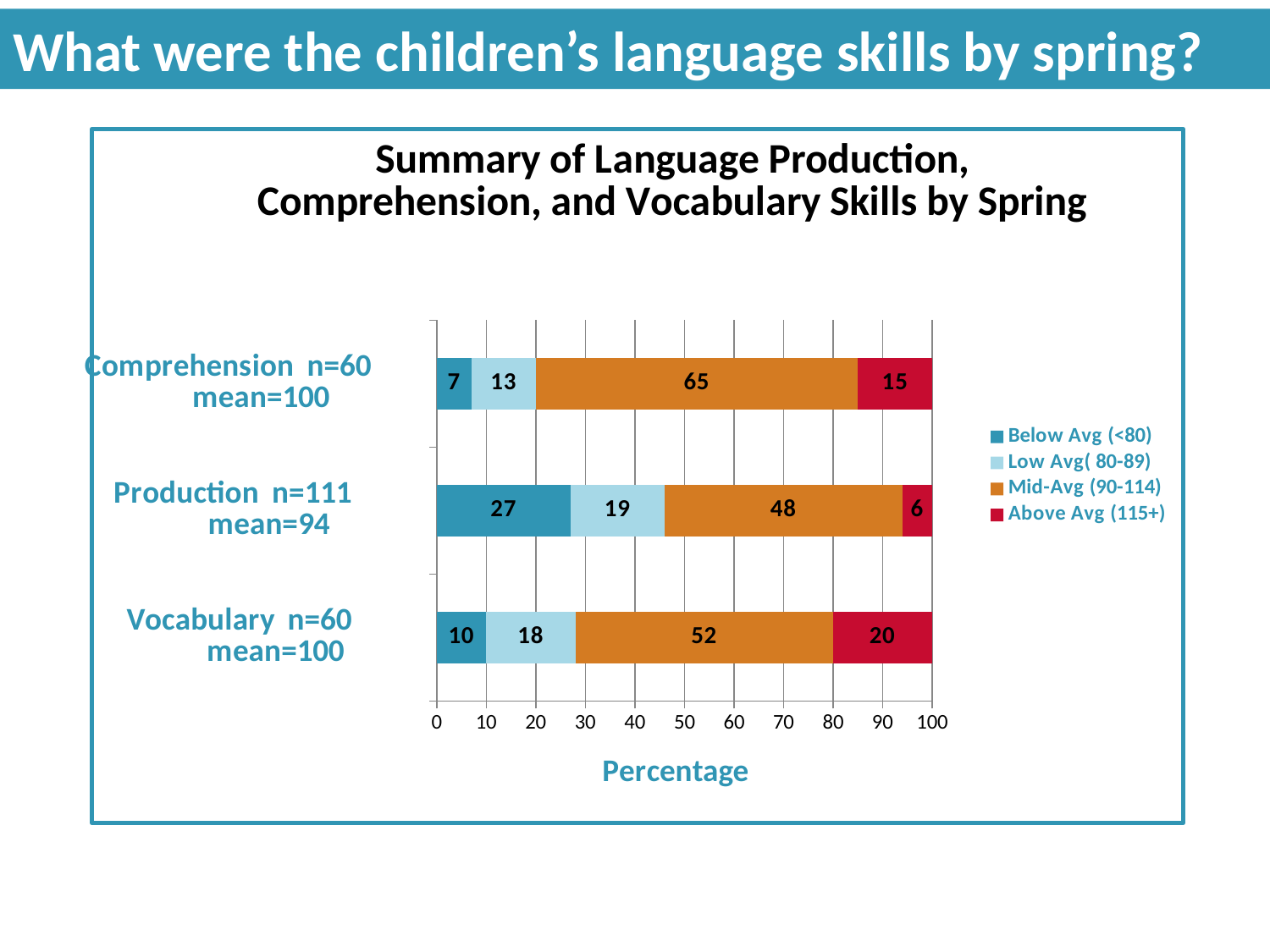
What is the Mid-Avg (90-114) value for Comprehension? 65 What is the label of the horizontal axis? Percentage What is the Below Avg (<80) value for Production? 27 Which category has the lowest Below Avg (<80) value? Comprehension What is the Above Avg (115+) value for Vocabulary? 20 Which is larger, the Low Avg (80-89) value for Production or for Comprehension? Production How many categories are shown on the chart? 3 Which category has the highest Above Avg (115+) value? Vocabulary What is the Low Avg (80-89) value for Vocabulary? 18 What is the difference between the Mid-Avg (90-114) values for Comprehension and Production? 17 How many series does the legend list? 4 What kind of chart is shown? Stacked bar chart